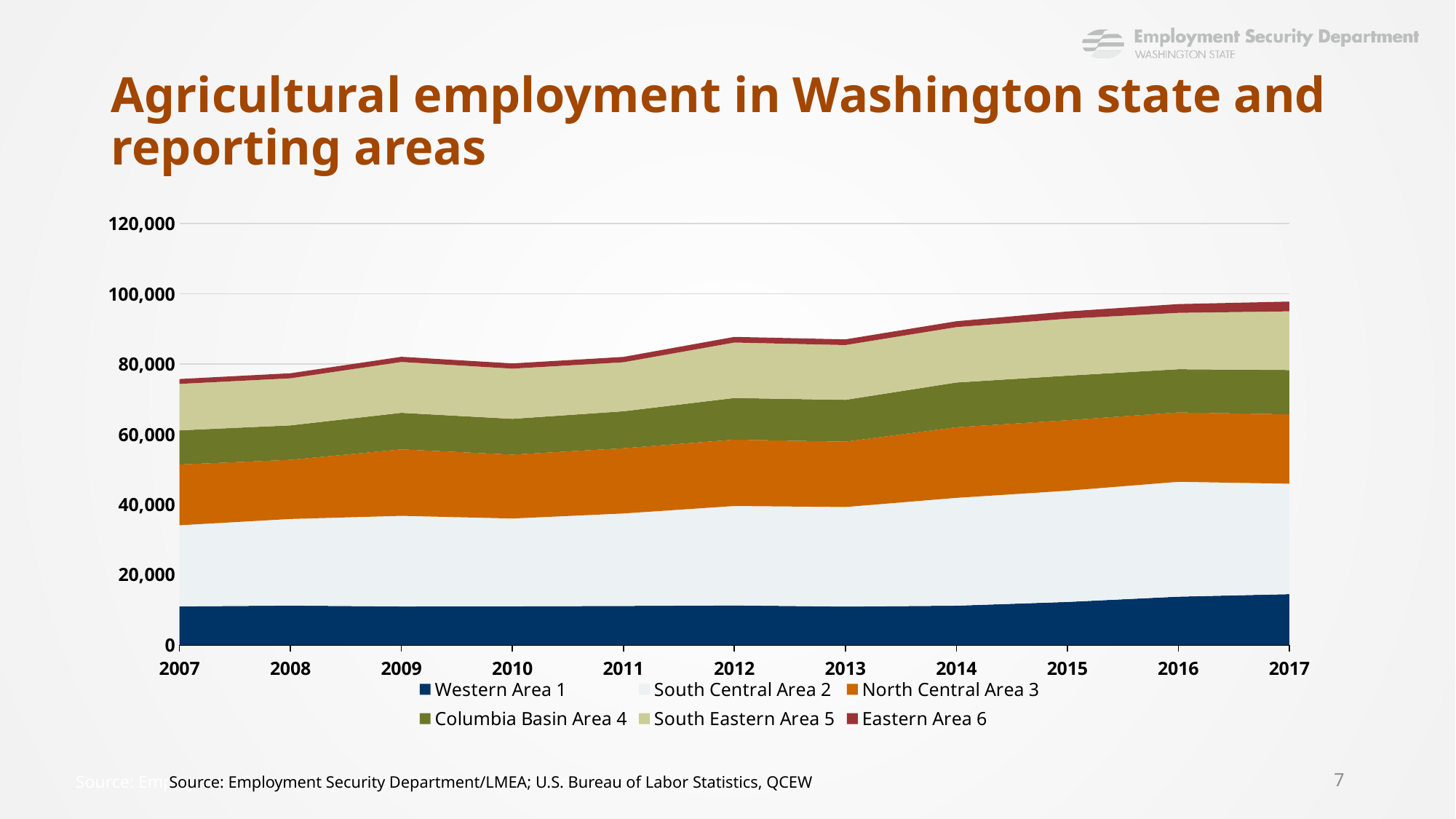
Does total agricultural employment generally rise or fall from 2007 to 2017? Rise Is the value for Western Area 1 in 2007 greater or less than 20,000? less Is the total agricultural employment in 2012 greater or less than 80,000? greater What kind of chart is shown on the slide? Stacked area chart Which series is shown in orange? North Central Area 3 Is the total agricultural employment in 2007 greater or less than 80,000? less Which year has the lowest total agricultural employment? 2007 How many series does the legend list? 6 Which year has the highest total agricultural employment? 2017 How many years are plotted along the x axis? 11 Which series is shown at the bottom of the stack in dark blue? Western Area 1